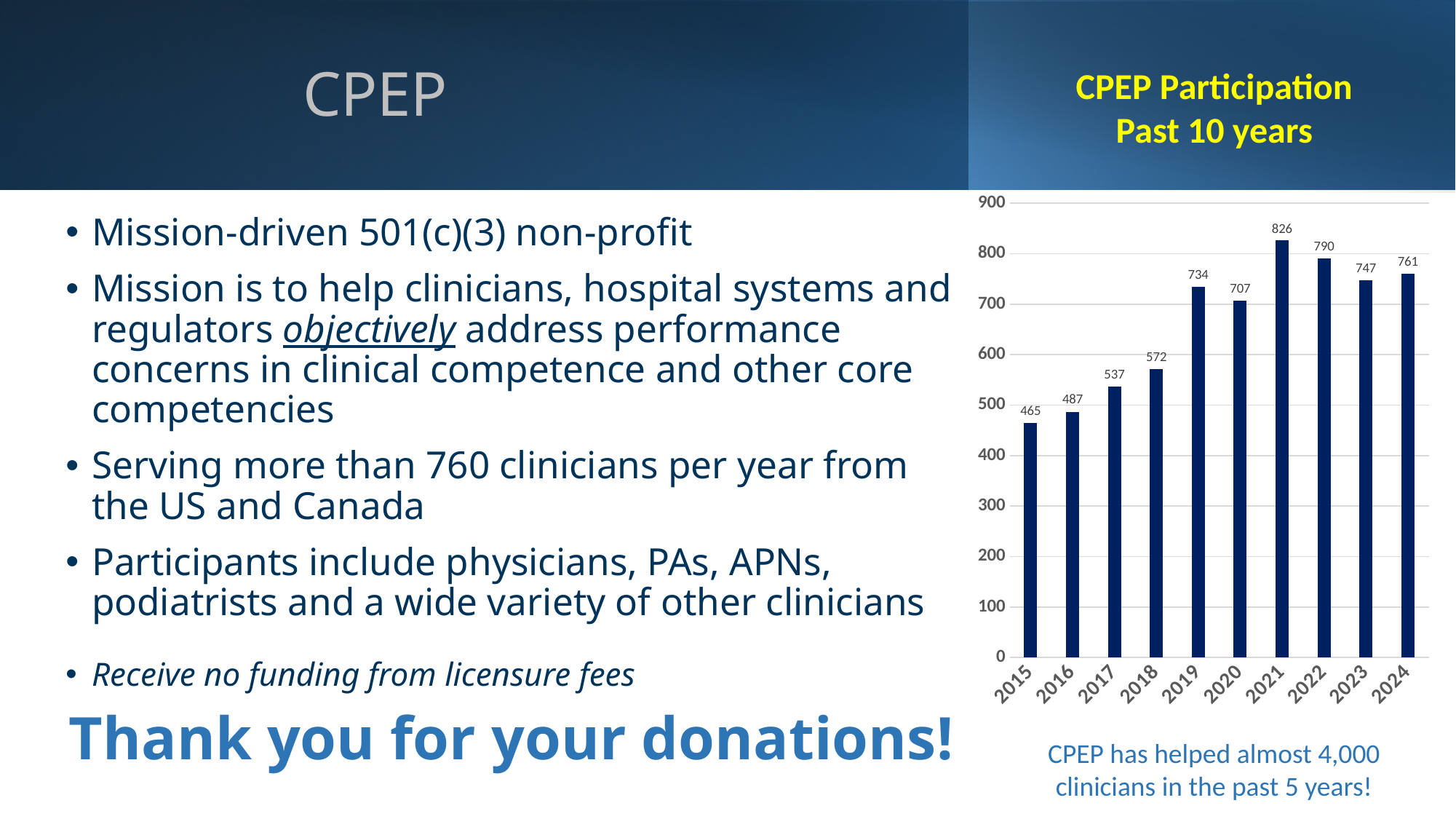
What is the value for 2021? 826 What is the value for 2024? 761 Which year has the highest value? 2021 What kind of chart is shown? bar chart What is the difference between the values for 2021 and 2015? 361 What is the title of the chart? CPEP Participation Past 10 years Which year has the lowest value? 2015 What is the value for 2015? 465 Which is larger, the value for 2019 or the value for 2020? 2019 Do the values generally rise or fall from 2015 to 2019? rise How many years are shown on the x axis? 10 Is the value for 2018 greater or less than 600? less